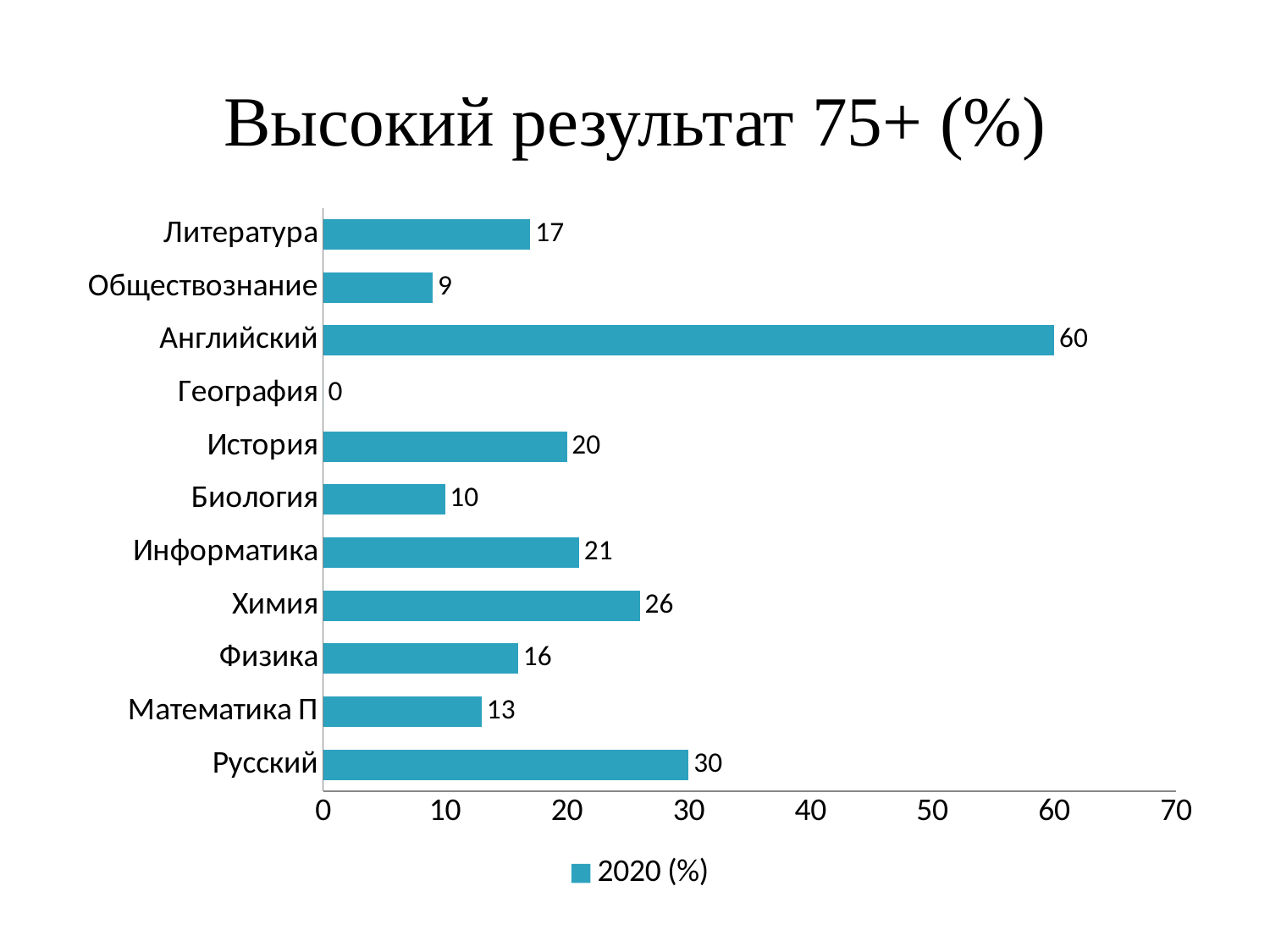
What is the value for Английский? 60 What is the title of the chart? Высокий результат 75+ (%) Is the value for Химия greater or less than 20? greater How many categories are shown on the chart? 11 What is the difference between the values for Английский and Русский? 30 What kind of chart is shown on the slide? bar chart Which category has the lowest value? География Which is larger, the value for Информатика or the value for Биология? Информатика How many series does the legend list? 1 What is the value for Русский? 30 Which category has the highest value? Английский What is the value for Химия? 26